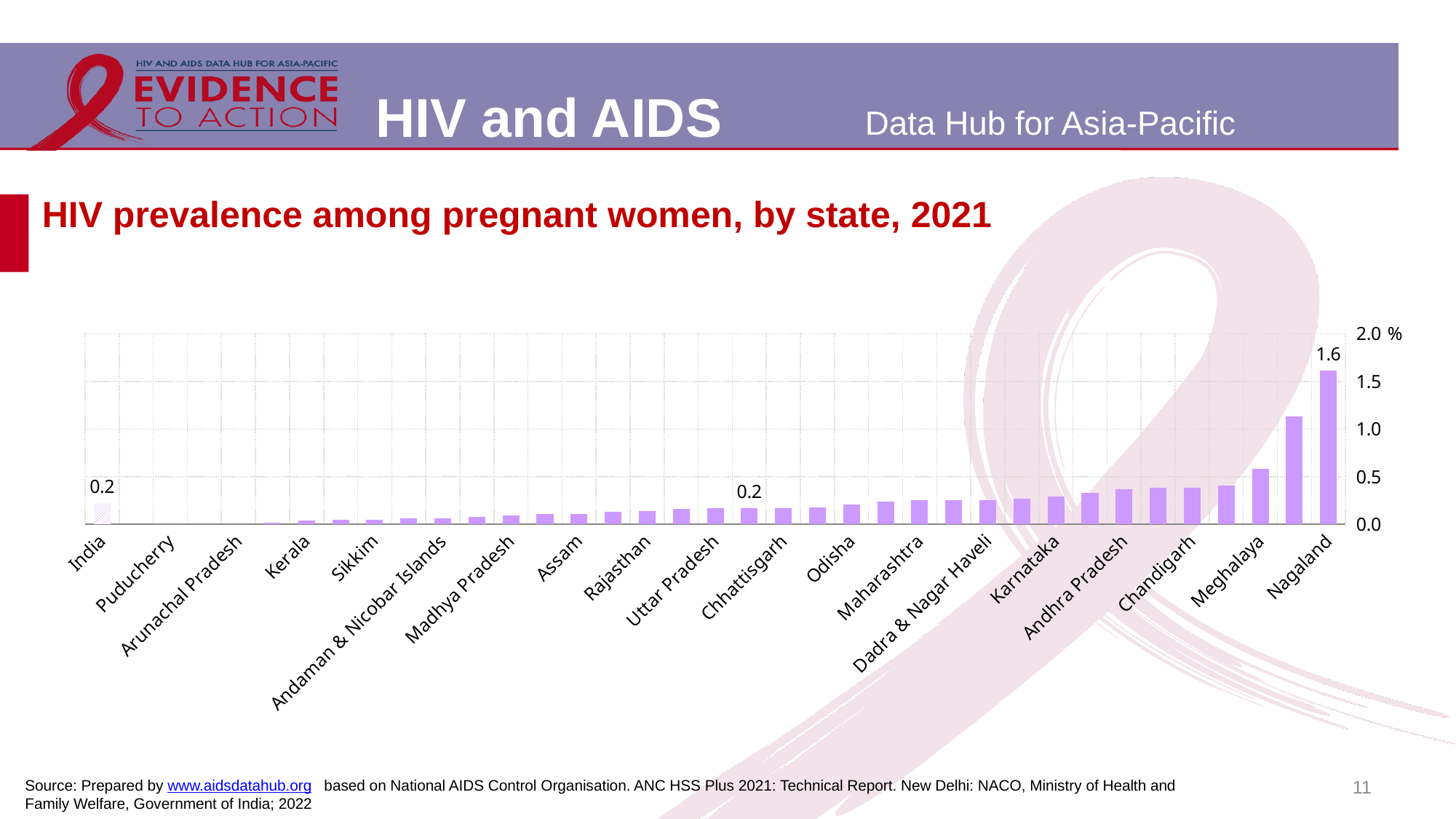
Is the value for Chandigarh greater or less than 0.5? less What type of chart is shown on the slide? bar chart What is the HIV prevalence value shown for Nagaland? 1.6 Is the value for Nagaland greater or less than 1.5? greater What is the HIV prevalence value shown for Chhattisgarh? 0.2 Which state has the highest HIV prevalence among pregnant women in the chart? Nagaland Which has a larger value, Meghalaya or Kerala? Meghalaya What is the HIV prevalence value shown for India? 0.2 What is the title of the chart? HIV prevalence among pregnant women, by state, 2021 Do the values generally rise or fall moving from left to right along the x axis? rise What is the difference between the values for Nagaland and India? 1.4 Which has a larger value, Nagaland or India? Nagaland